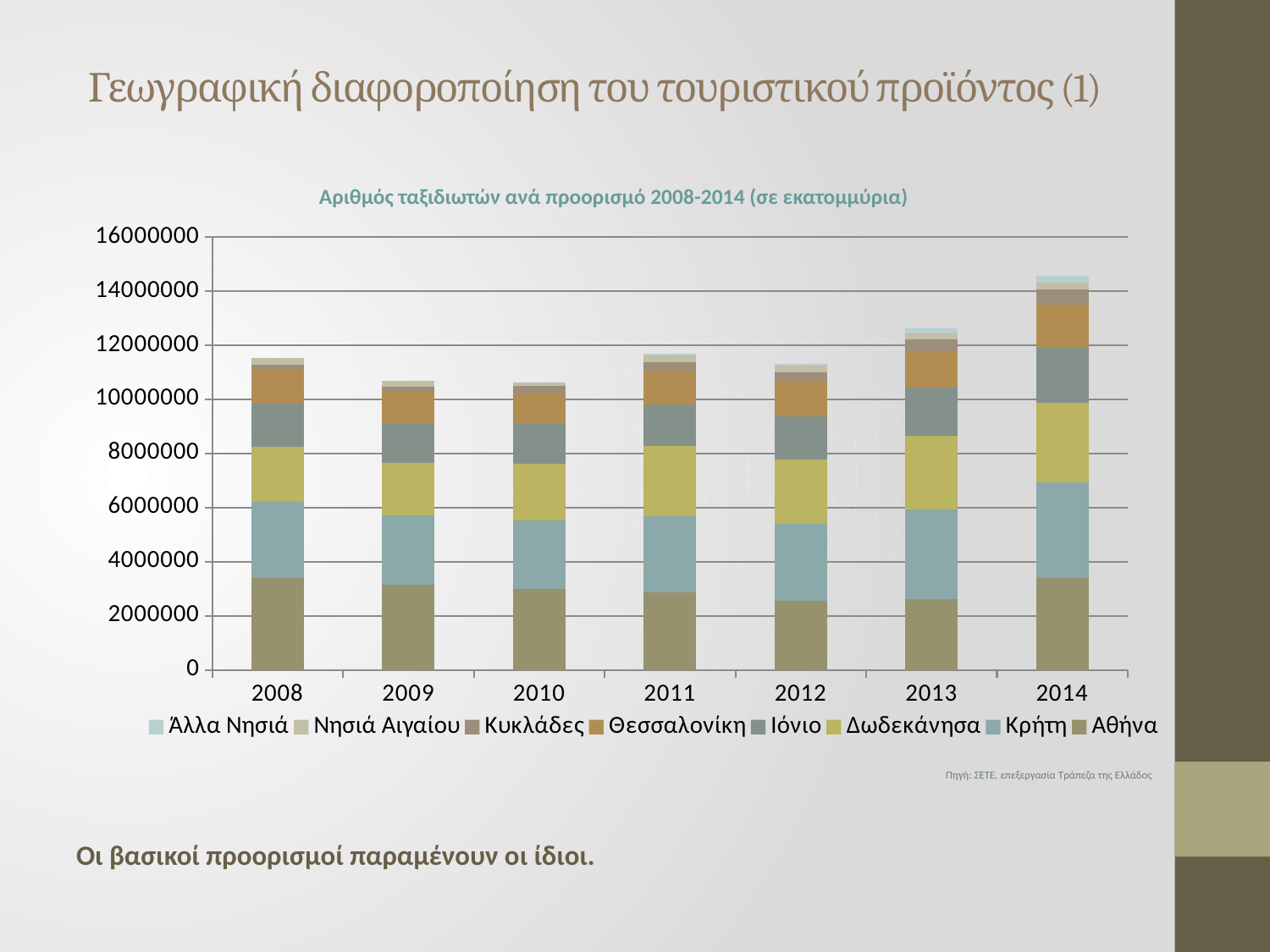
Is the total for 2008 greater or less than 12000000? less What is the title of the chart? Αριθμός ταξιδιωτών ανά προορισμό 2008-2014 (σε εκατομμύρια) Which year has the highest total number of travellers? 2014 Is the total for 2012 greater or less than 12000000? less How many years are shown on the x axis of the chart? 7 How many series does the chart legend list? 8 Which series is listed last in the chart legend? Αθήνα Do the total bar heights rise or fall from 2012 to 2014? rise Is the total for 2014 greater or less than 14000000? greater What kind of chart is shown on the slide? stacked bar chart Which year has the larger total, 2012 or 2014? 2014